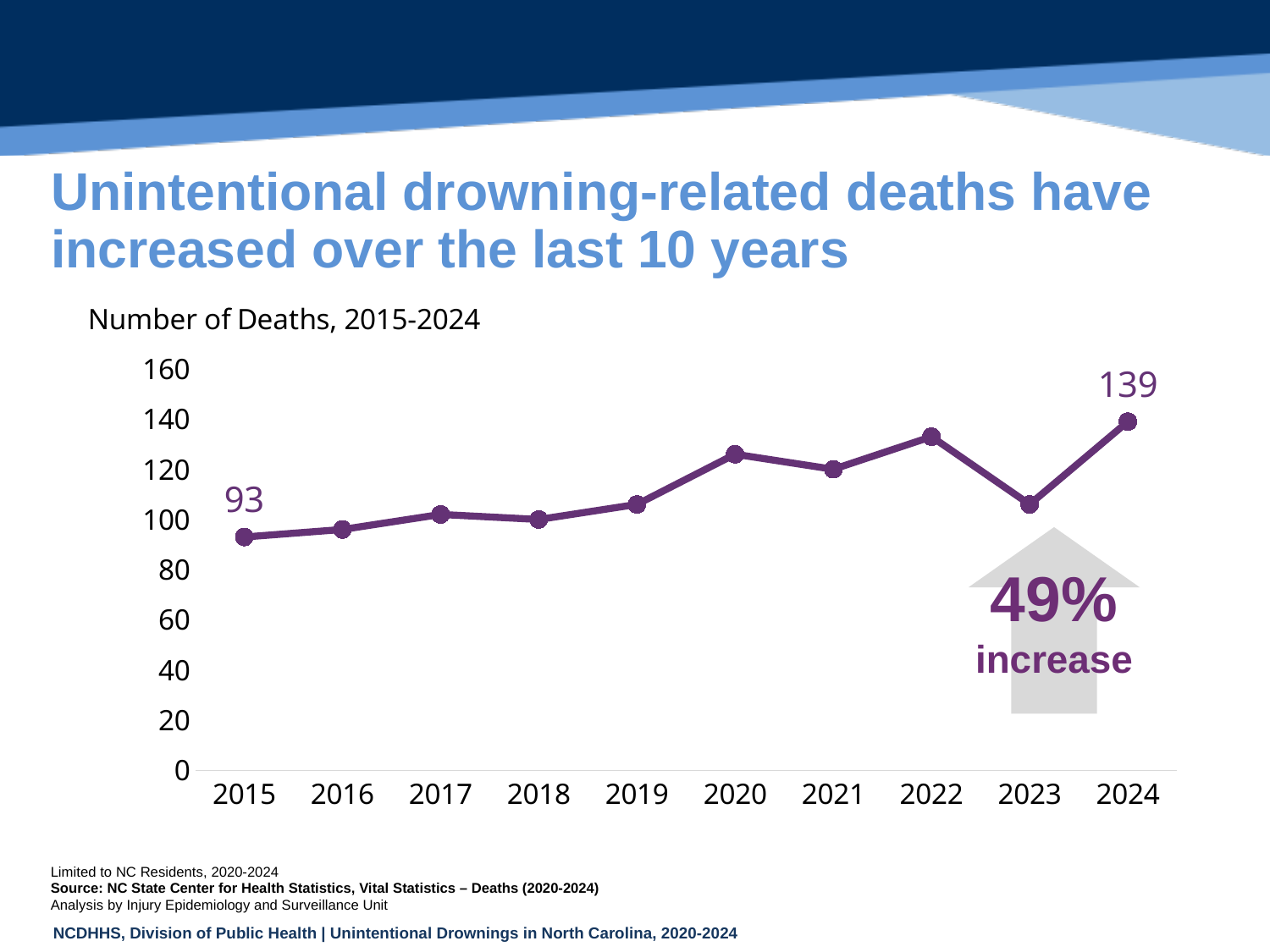
What kind of chart is shown on the slide? Line chart What is the number of deaths in 2015? 93 What is the number of deaths in 2024? 139 Is the value for 2017 greater or less than 120? less Is the value for 2020 greater or less than 100? greater How many years are plotted on the chart? 10 Is the value for 2022 greater or less than 120? greater What is the difference between the number of deaths in 2024 and in 2015? 46 Overall, do the number of deaths rise or fall from 2015 to 2024? Rise What percentage increase is highlighted in the arrow annotation on the chart? 49% increase Which year has more deaths, 2022 or 2023? 2022 Which year has the highest number of deaths? 2024